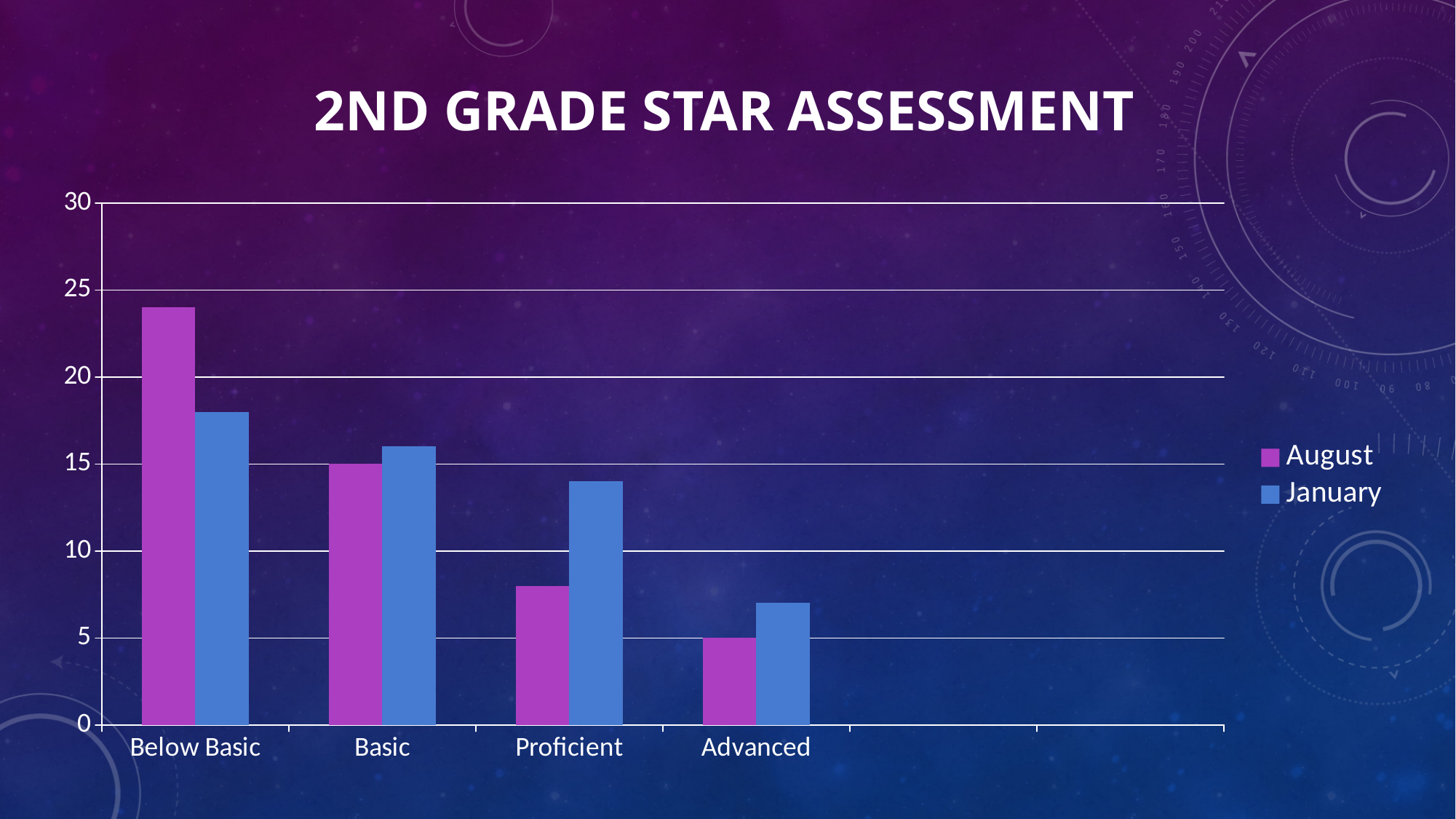
What is the title of the chart? 2nd Grade Star Assessment Is the January value for Proficient greater or less than 10? greater Which category has the highest August value? Below Basic What is the August value for Basic? 15 What kind of chart is shown on the slide? bar chart Which category has the lowest January value? Advanced How many series does the legend list? 2 For Proficient, which is larger, the August value or the January value? January Is the August value for Below Basic greater or less than 20? greater What is the August value for Advanced? 5 Do the August values rise or fall from Below Basic to Advanced? fall How many categories are shown on the x axis? 4